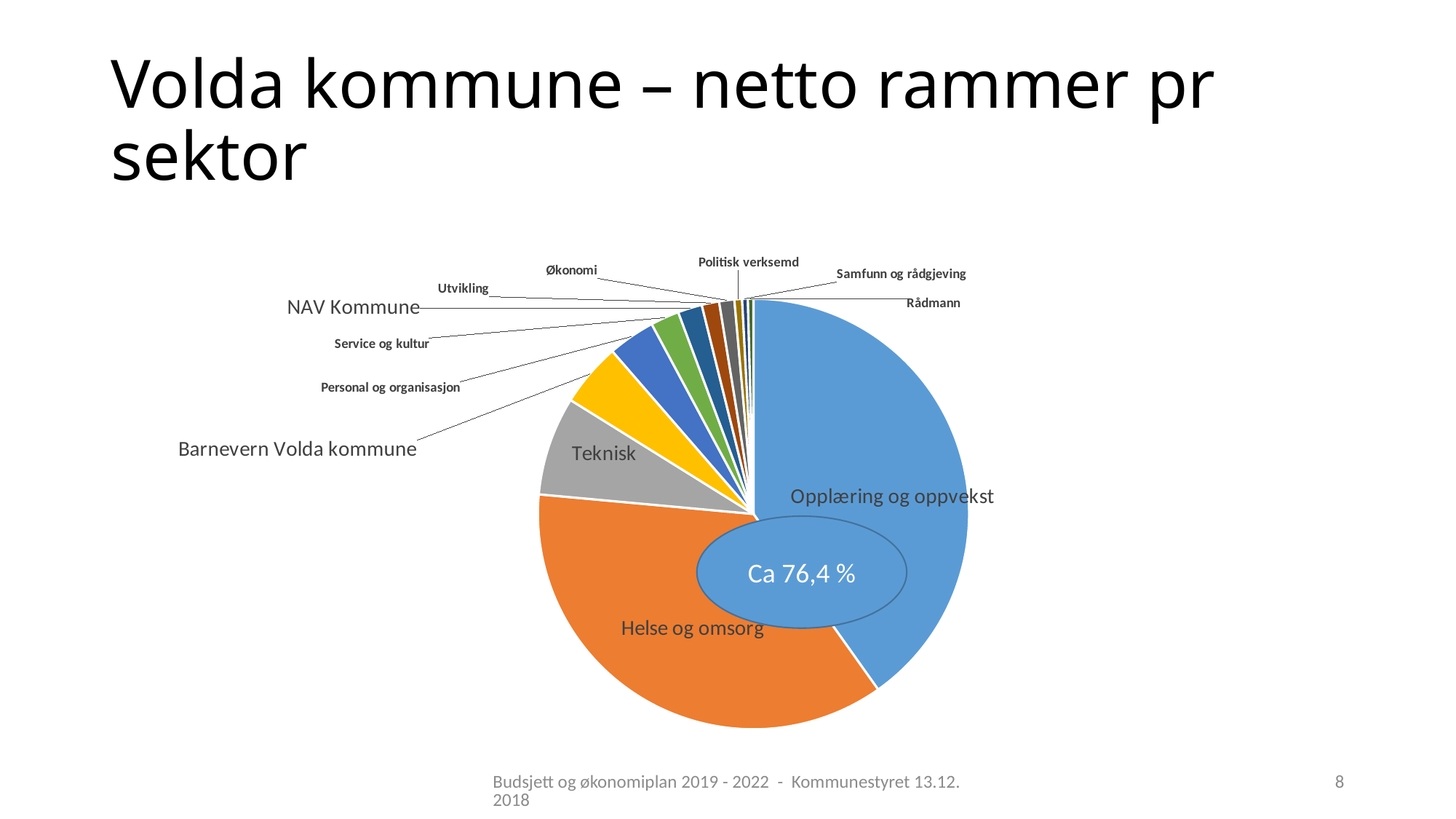
What is the title of the slide containing the pie chart? Volda kommune – netto rammer pr sektor Which slice is larger, Opplæring og oppvekst or Helse og omsorg? Opplæring og oppvekst Which slice is larger, Helse og omsorg or Teknisk? Helse og omsorg What percentage is written in the oval annotation placed over the pie chart? Ca 76,4 % What kind of chart is shown on the slide? pie chart Which slice is larger, Barnevern Volda kommune or Personal og organisasjon? Barnevern Volda kommune How many sectors (slices) are labelled in the pie chart? 12 Which sector has the largest slice in the pie chart? Opplæring og oppvekst